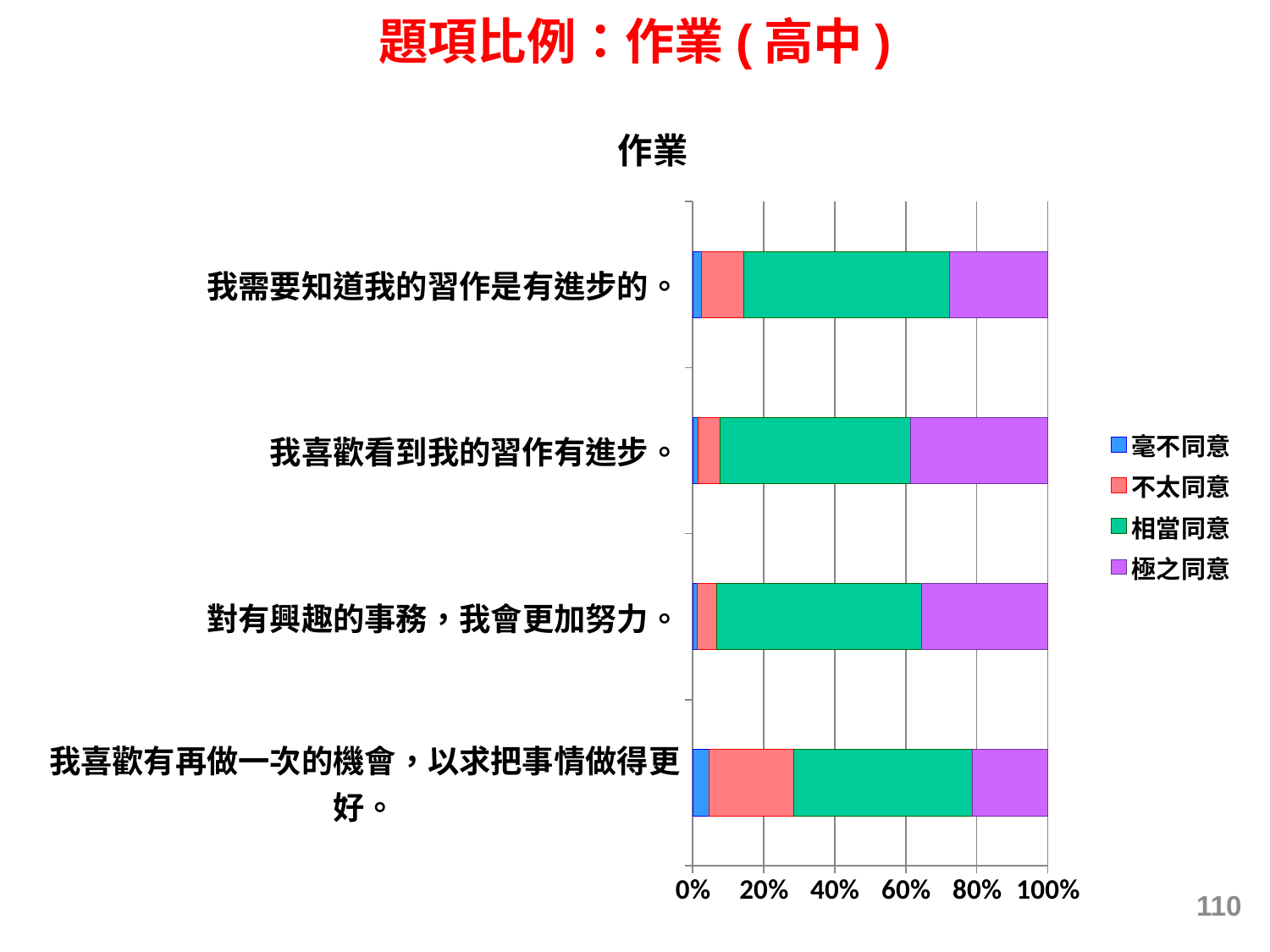
Is the 極之同意 share for 我喜歡有再做一次的機會，以求把事情做得更好。 greater or less than 40%? less How many statements (categories) are plotted in the chart? 4 Which statement has the smallest 極之同意 share? 我喜歡有再做一次的機會，以求把事情做得更好。 Which statement has the largest 毫不同意 share? 我喜歡有再做一次的機會，以求把事情做得更好。 Which legend entry is shown in purple? 極之同意 What is the title of the chart? 作業 Is the 極之同意 share for 我喜歡看到我的習作有進步。 greater or less than 20%? greater What kind of chart is shown on the slide? Stacked bar chart Which has the larger 極之同意 share: 我需要知道我的習作是有進步的。 or 我喜歡看到我的習作有進步。? 我喜歡看到我的習作有進步。 Is the 相當同意 share for 我需要知道我的習作是有進步的。 greater or less than 40%? greater How many series does the legend list? 4 Which statement has the largest 不太同意 share? 我喜歡有再做一次的機會，以求把事情做得更好。